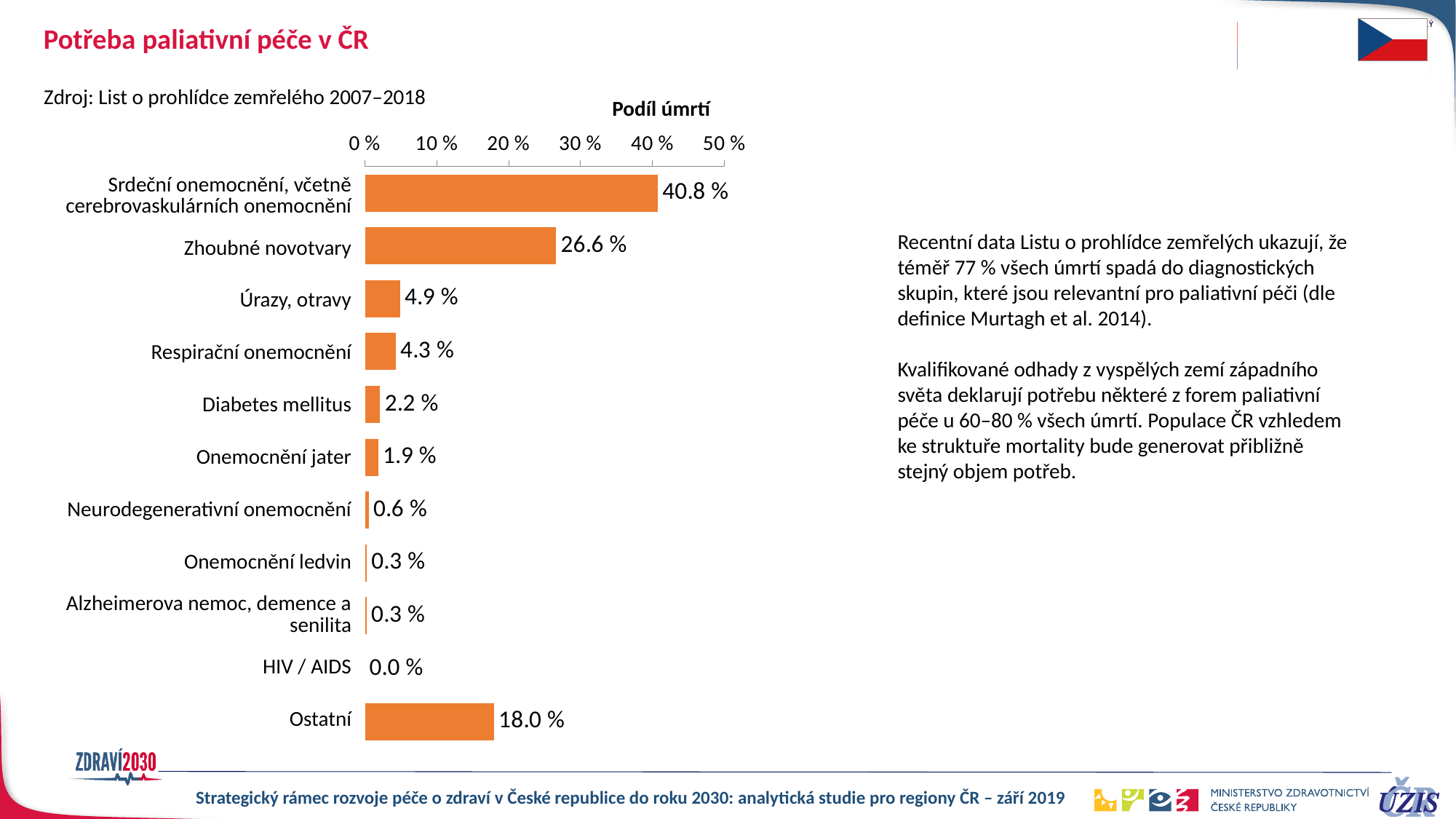
What is the value for Zhoubné novotvary? 26.6 % What is the value for Diabetes mellitus? 2.2 % What kind of chart is shown on the slide? bar chart What is the value for Ostatní? 18.0 % Which category has the highest value? Srdeční onemocnění, včetně cerebrovaskulárních onemocnění How many categories are shown in the chart? 11 Is the value for Ostatní greater or less than 20 %? less Which category has the lowest value? HIV / AIDS What is the value for HIV / AIDS? 0.0 % What is the difference between the values for Srdeční onemocnění, včetně cerebrovaskulárních onemocnění and Zhoubné novotvary? 14.2 % Which is larger, the value for Úrazy, otravy or the value for Respirační onemocnění? Úrazy, otravy What is the title of the chart? Podíl úmrtí